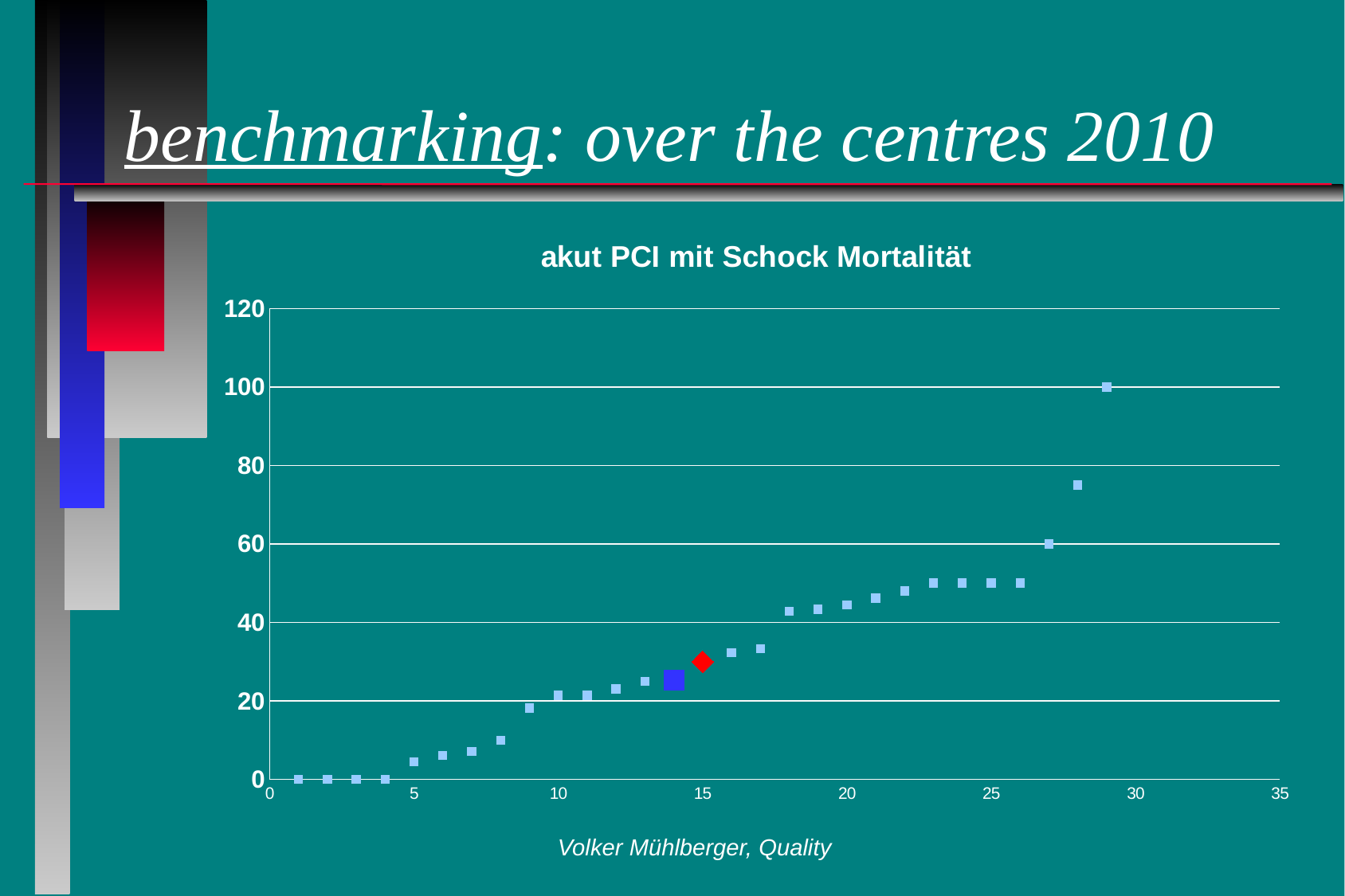
What kind of chart is shown on the slide? scatter chart What is the value of the point at x = 2? 0 Is the value of the red diamond point at x = 15 greater or less than 40? less What is the highest value shown on the y-axis? 120 What is the lowest value plotted on the chart? 0 What is the value of the point at x = 29? 100 Do the plotted values generally rise or fall as the x-axis value increases? rise Is the value of the point at x = 28 greater or less than 60? greater What is the value of the point at x = 27? 60 Which point has the larger value, the one at x = 10 or the one at x = 20? x = 20 What is the title of the chart? akut PCI mit Schock Mortalität At which x value is the highest point plotted? 29